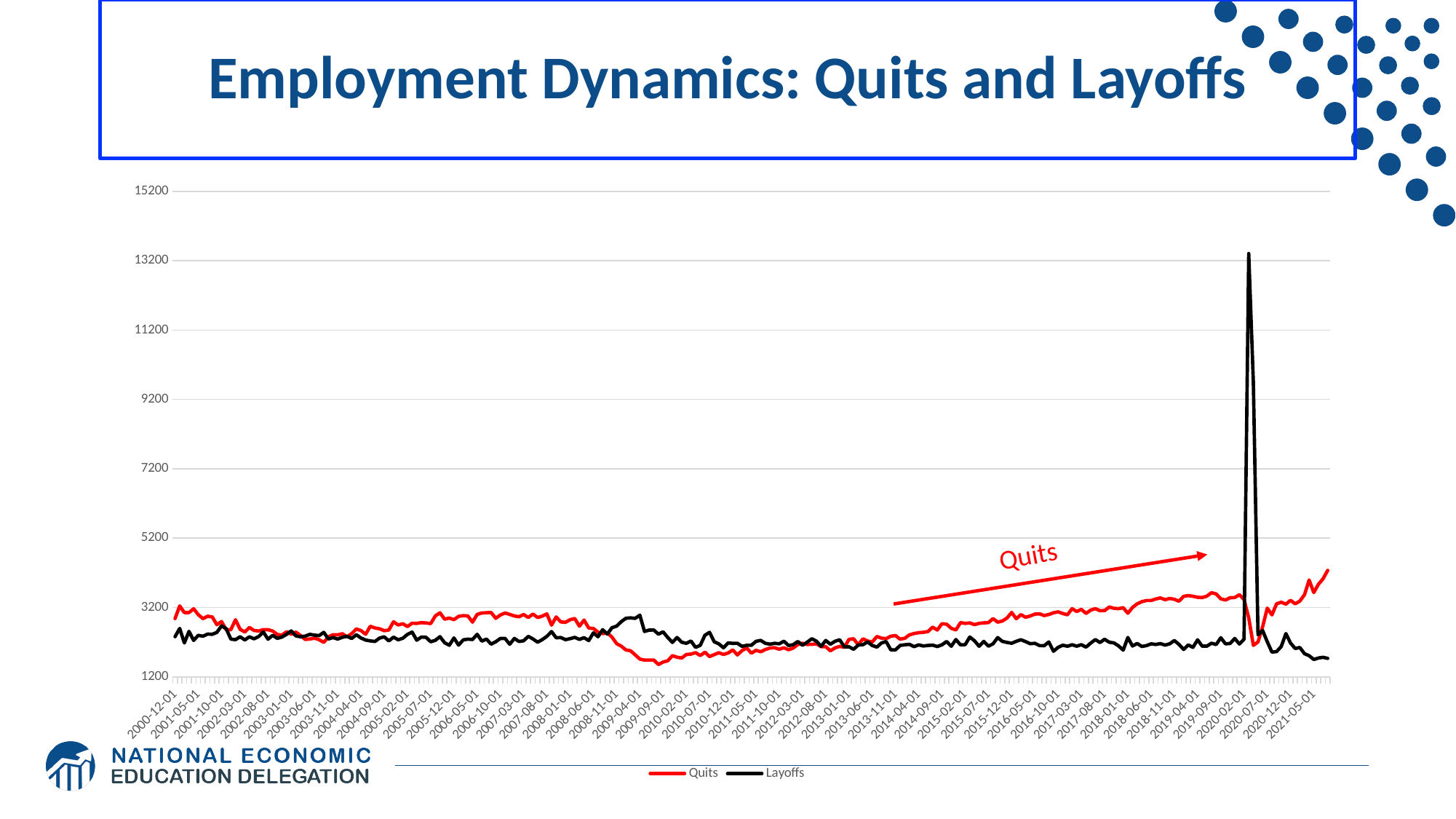
What colour is the Layoffs line? black Which series reaches the highest peak on the chart? Layoffs Is the value of Quits around 2009-09-01 greater or less than 3200? less Is the value of Quits at the last date (2021-05-01) greater or less than 3200? greater Is the value of Layoffs at the last date (2021-05-01) greater or less than 3200? less What is the highest value shown on the y axis? 15200 At the last date on the x axis, which series has the higher value, Quits or Layoffs? Quits What kind of chart is shown on the slide? line chart What are the two series named in the legend? Quits and Layoffs How many series does the legend list? 2 Does the Quits series generally rise or fall between 2013 and 2019? rise